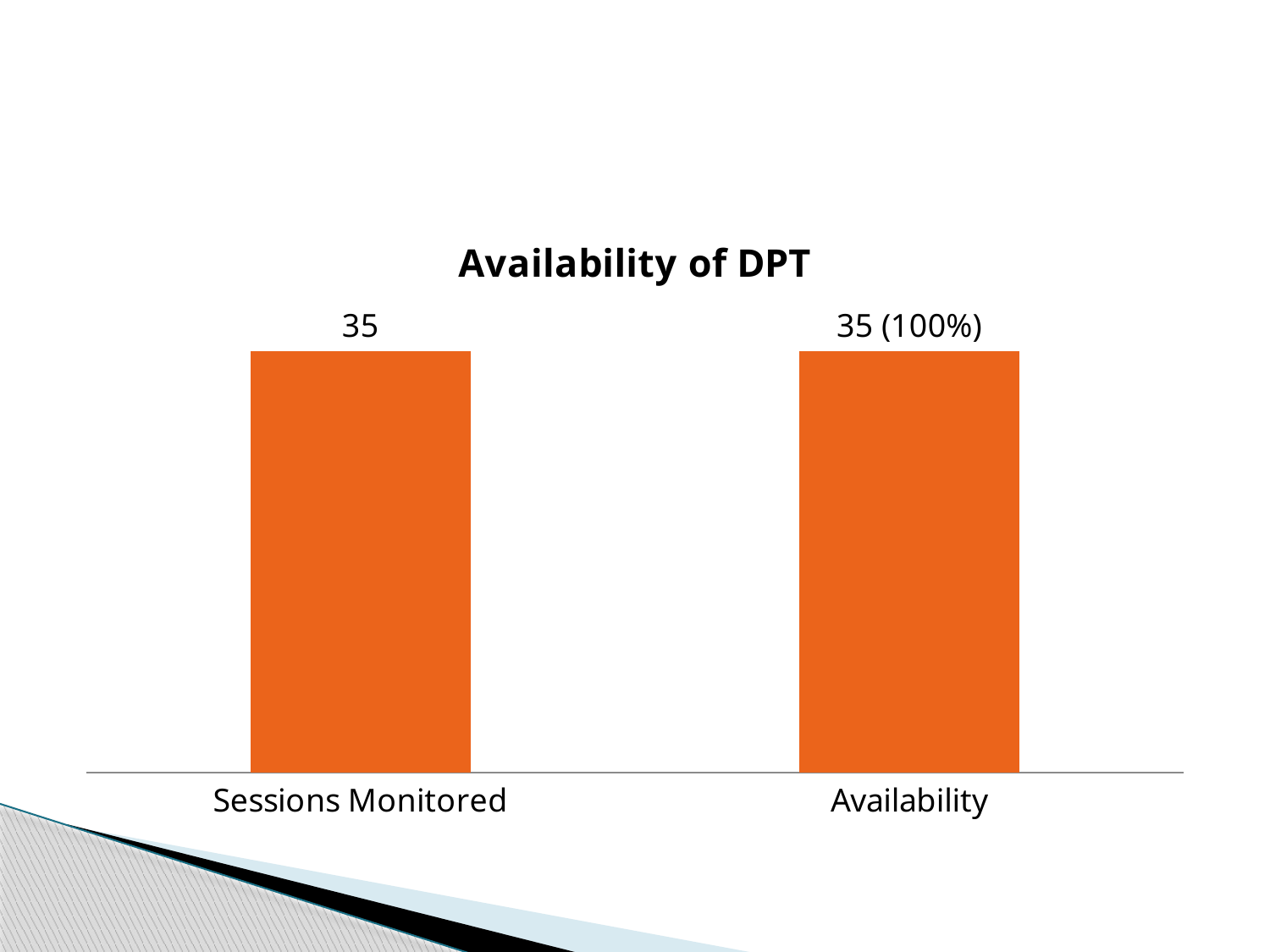
How many categories are shown on the x axis? 2 What colour are the bars in the chart? Orange What is the data label shown on the Availability bar? 35 (100%) What kind of chart is shown on the slide? Bar chart What is the label of the second category on the x axis? Availability What is the title of the chart? Availability of DPT What percentage is shown in the data label for Availability? 100% What is the value for Sessions Monitored? 35 What is the difference between the Sessions Monitored value and the Availability value? 0 What is the label of the first category on the x axis? Sessions Monitored